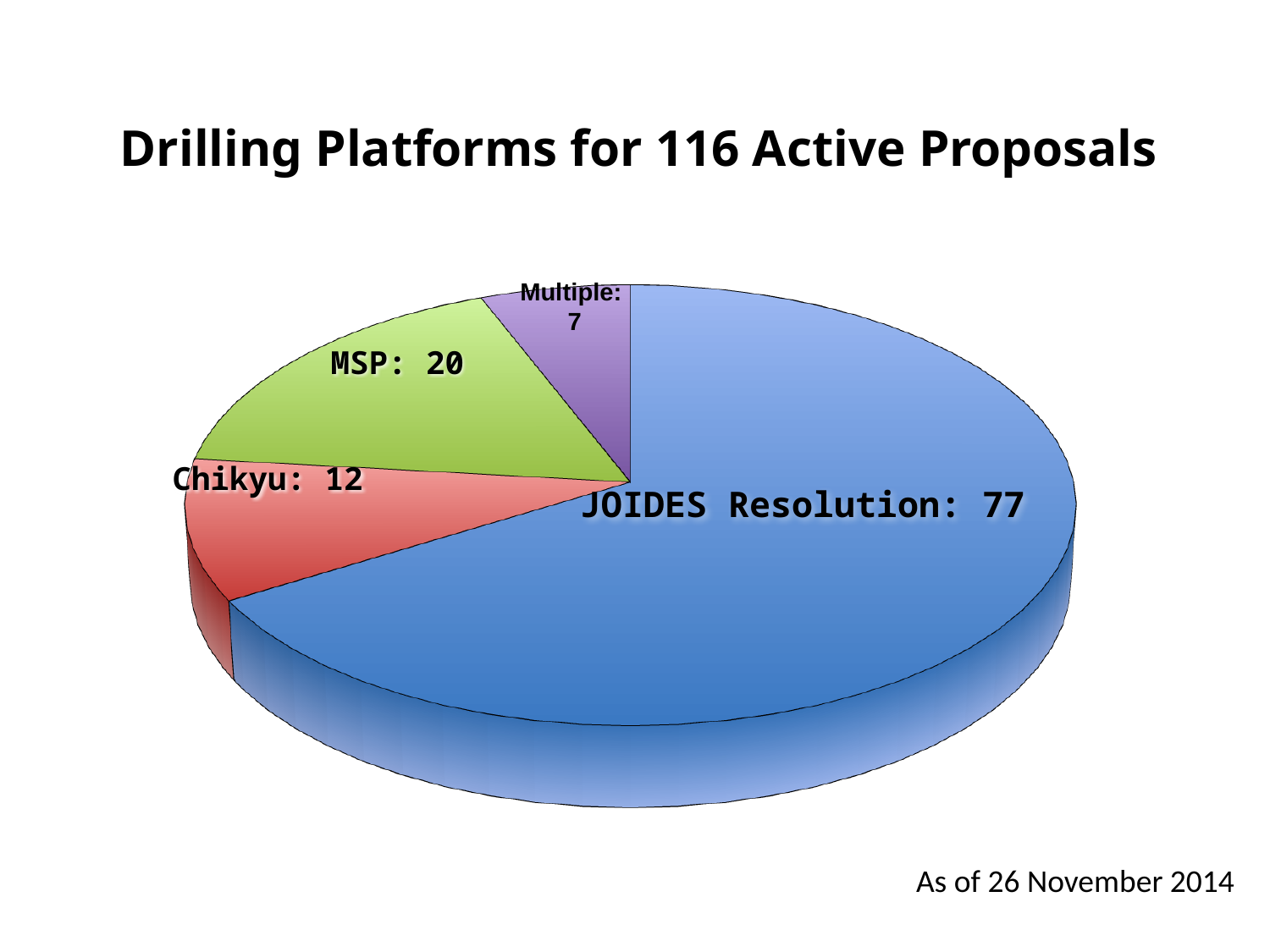
Which category has the smallest number of active proposals? Multiple How many active proposals are assigned to Chikyu? 12 How many active proposals are assigned to the JOIDES Resolution? 77 Which drilling platform has the largest number of active proposals? JOIDES Resolution How many active proposals are assigned to Multiple platforms? 7 How many active proposals are assigned to MSP? 20 What is the difference between the number of proposals for JOIDES Resolution and for MSP? 57 To the nearest whole percent, what share of the 116 active proposals does the JOIDES Resolution slice represent? 66% What type of chart is shown on the slide? Pie chart What is the difference between the number of proposals for MSP and for Chikyu? 8 How many slices does the pie chart have? 4 Which has more active proposals, Chikyu or MSP? MSP